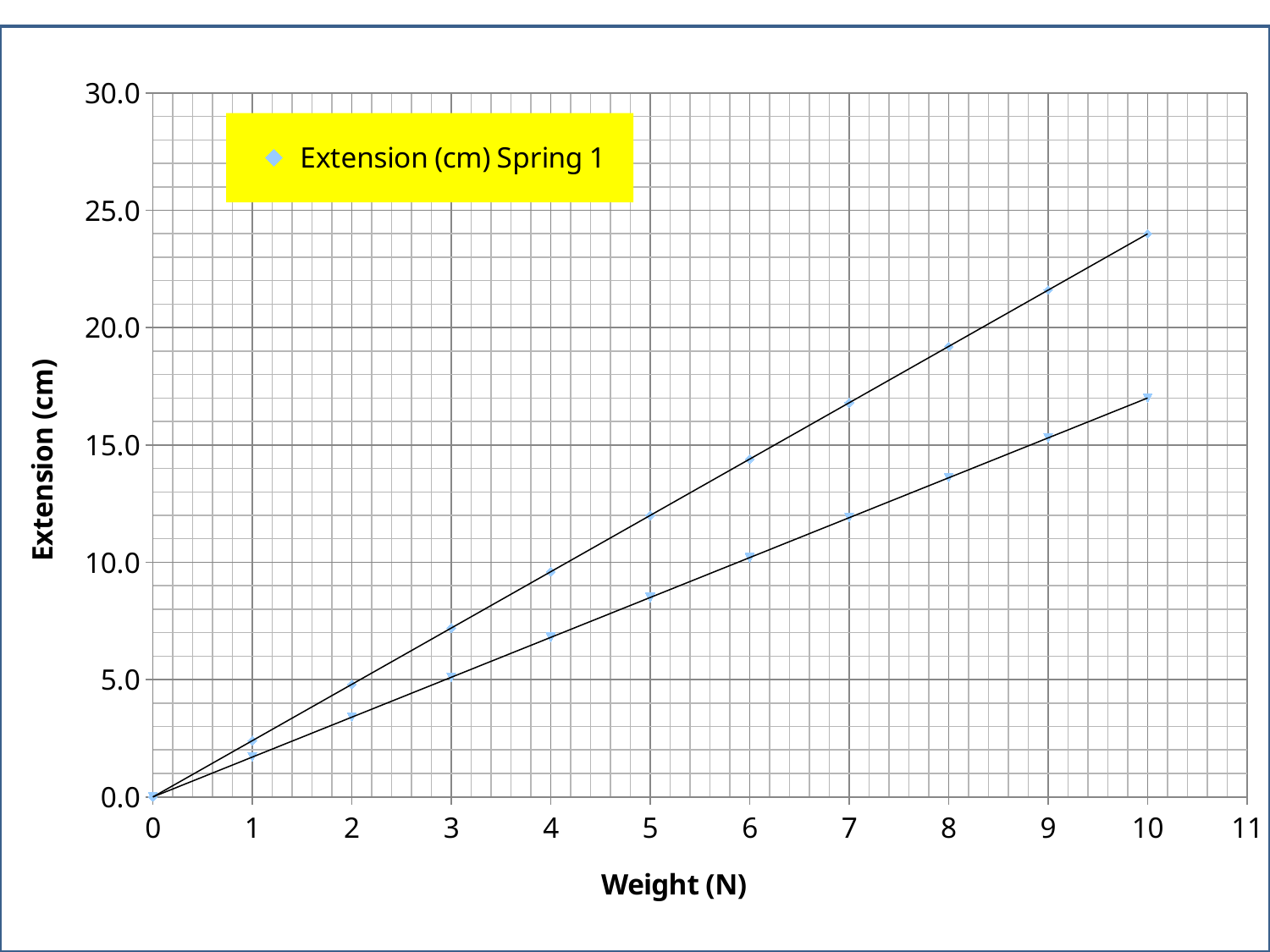
How many data points are plotted on the steeper (upper) line, from 0 N to 10 N? 11 What is the title of the x axis? Weight (N) What is the legend entry shown on the chart? Extension (cm) Spring 1 At a weight of 10 N, is the extension on the shallower (lower) line greater or less than 20.0? less At a weight of 5 N, is the extension on the steeper (upper) line greater or less than 10.0? greater Do the plotted extension values rise or fall as weight increases along the x axis? rise At a weight of 10 N, is the extension on the steeper (upper) line greater or less than 20.0? greater How many series does the legend list? 1 At a weight of 8 N, which line shows the larger extension, the upper line or the lower line? the upper line What kind of chart is shown on the slide? scatter chart